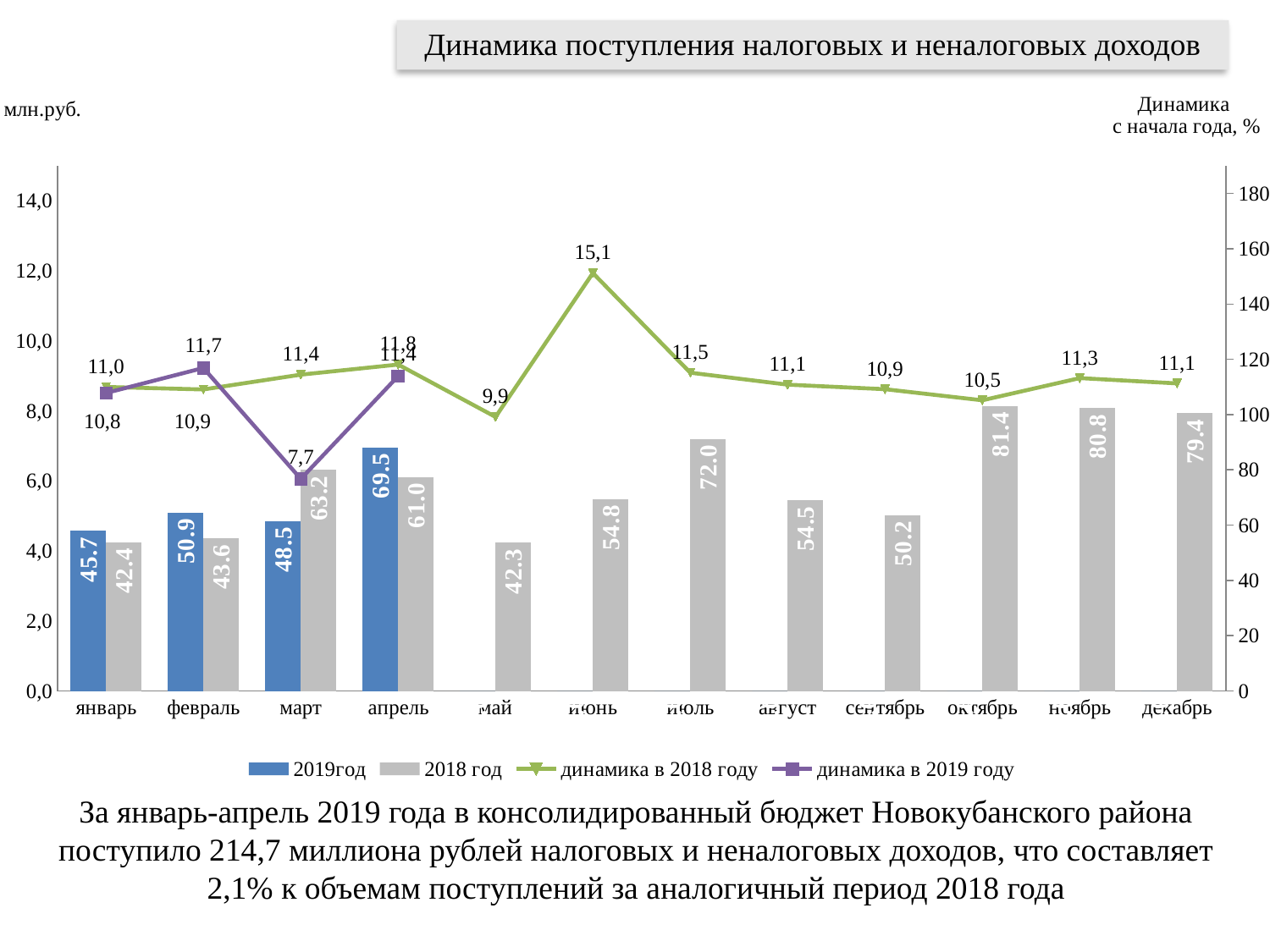
Which month has the highest 2018 год bar? октябрь What is the value of the динамика в 2018 году line for июнь? 15,1 What kind of chart is shown on the slide? Combined bar and line chart For март, which is larger: the 2019 год bar or the 2018 год bar? 2018 год What is the value of the 2019 год bar for апрель? 69.5 Which month has the lowest 2018 год bar? май What is the value of the 2018 год bar for октябрь? 81.4 How many series does the legend list? 4 What is the difference between the 2019 год and 2018 год bars for апрель? 8.5 In which month does the динамика в 2018 году line reach its highest value? июнь Which month has the highest 2019 год bar? апрель How many months are shown on the x axis? 12